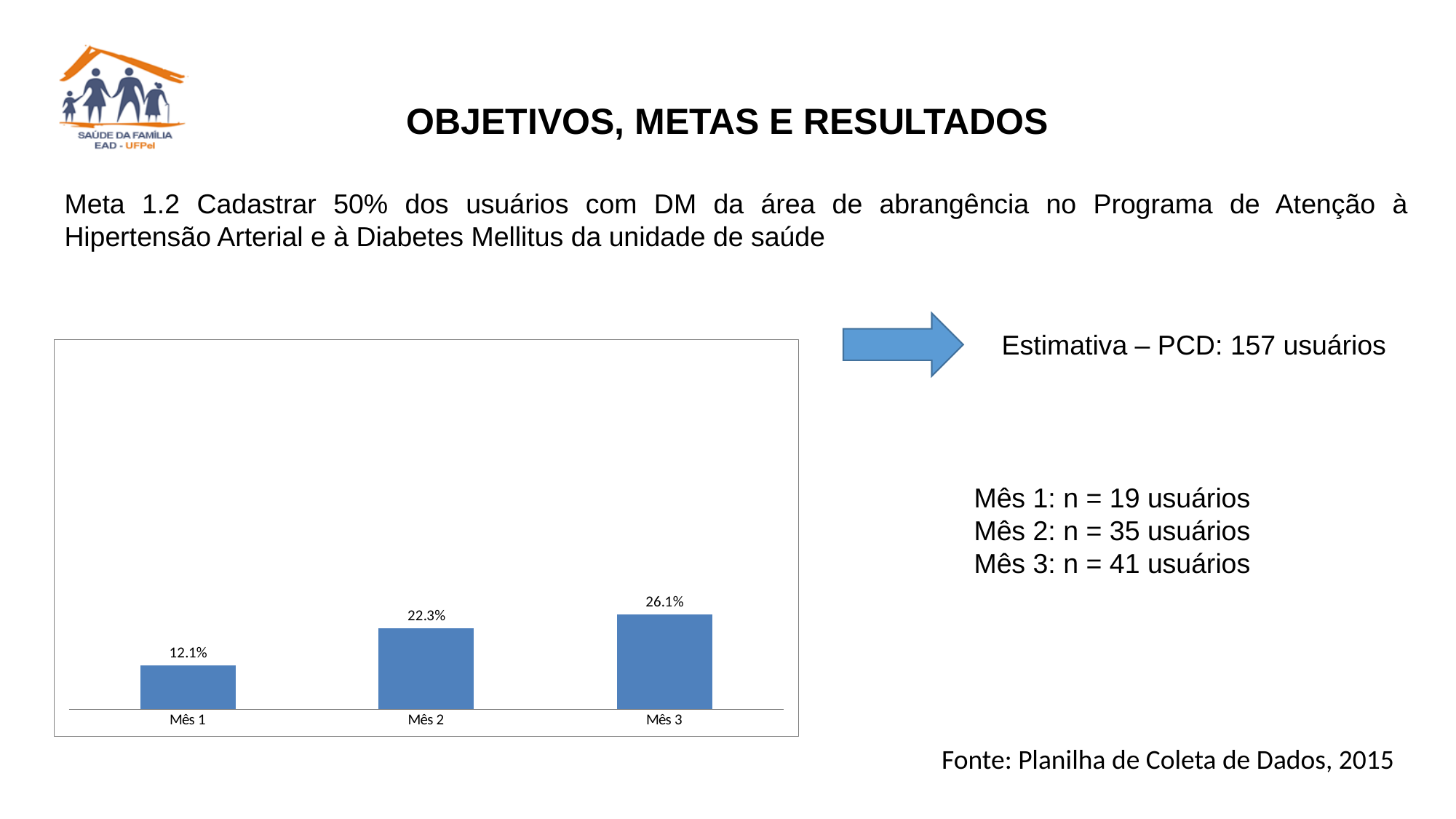
What is the difference between the values for Mês 2 and Mês 1? 10.2% What is the difference between the values for Mês 3 and Mês 1? 14.0% What kind of chart is shown on the slide? Bar chart How many categories are plotted in the chart? 3 Which month has the highest value in the chart? Mês 3 What is the value shown for Mês 1? 12.1% Do the values rise or fall from Mês 1 to Mês 3? Rise Which is larger, the value for Mês 2 or the value for Mês 3? Mês 3 What is the difference between the values for Mês 3 and Mês 2? 3.8% What is the value shown for Mês 3? 26.1% What is the value shown for Mês 2? 22.3% Which month has the lowest value in the chart? Mês 1